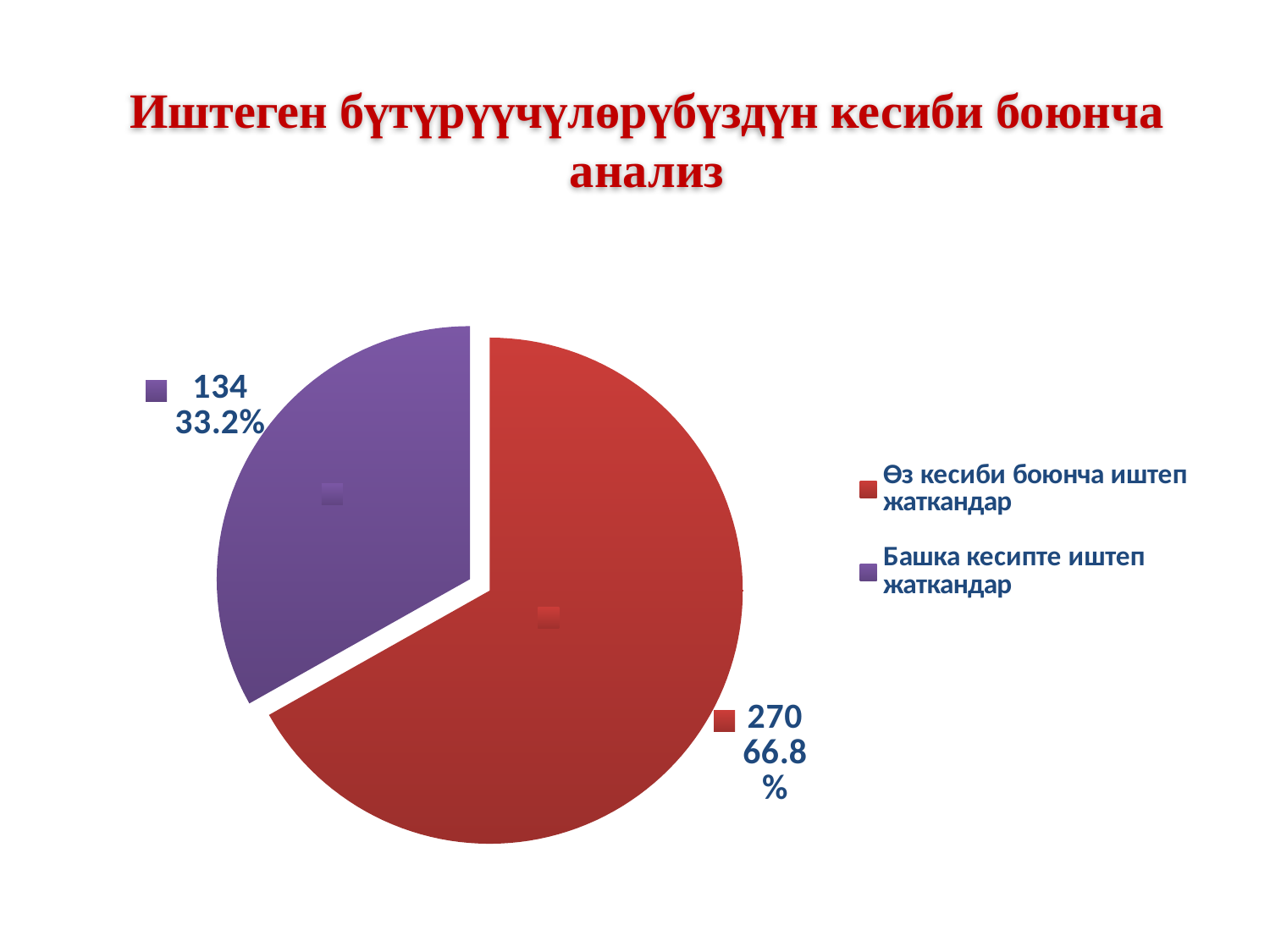
What kind of chart is shown on the slide? pie chart What is the total of the two values shown on the pie chart? 404 What share of the pie does "Башка кесипте иштеп жаткандар" take? 33.2% Which category has the smallest slice? Башка кесипте иштеп жаткандар What share of the pie does "Өз кесиби боюнча иштеп жаткандар" take? 66.8% What is the difference between the values for "Өз кесиби боюнча иштеп жаткандар" and "Башка кесипте иштеп жаткандар"? 136 What colour is the slice for "Башка кесипте иштеп жаткандар"? purple How many slices does the pie chart have? 2 What is the value for "Өз кесиби боюнча иштеп жаткандар"? 270 Which is larger: the value for "Өз кесиби боюнча иштеп жаткандар" or for "Башка кесипте иштеп жаткандар"? Өз кесиби боюнча иштеп жаткандар Which category has the largest slice? Өз кесиби боюнча иштеп жаткандар What is the value for "Башка кесипте иштеп жаткандар"? 134